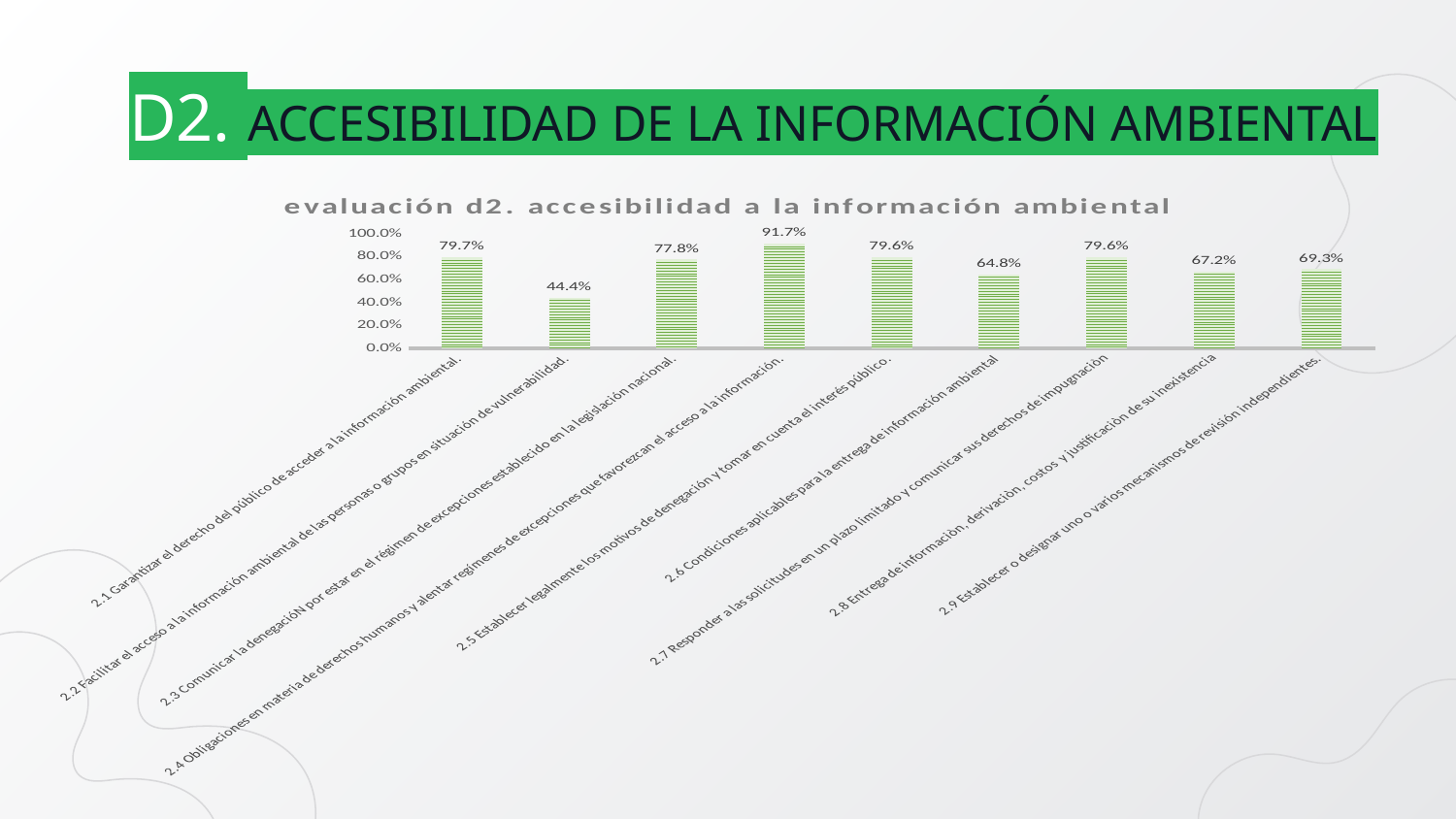
How many categories are plotted in the chart? 9 Which category has the highest value? 2.4 Obligaciones en materia de derechos humanos y alentar regímenes de excepciones que favorezcan el acceso a la información Which category has the lowest value? 2.2 Facilitar el acceso a la información ambiental de las personas o grupos en situación de vulnerabilidad Which has a larger value, category 2.6 or category 2.8? 2.8 Entrega de información, derivación, costos y justificación de su inexistencia What is the title of the chart? evaluación d2. accesibilidad a la información ambiental What is the value for category 2.4 (Obligaciones en materia de derechos humanos y alentar regímenes de excepciones que favorezcan el acceso a la información)? 91.7% What is the value for category 2.2 (Facilitar el acceso a la información ambiental de las personas o grupos en situación de vulnerabilidad)? 44.4% What is the difference between the highest value (category 2.4) and the lowest value (category 2.2)? 47.3 percentage points Is the value for category 2.2 greater or less than 60.0%? less What is the value for category 2.1 (Garantizar el derecho del público de acceder a la información ambiental)? 79.7% What is the value for category 2.9 (Establecer o designar uno o varios mecanismos de revisión independientes)? 69.3% What is the value for category 2.6 (Condiciones aplicables para la entrega de información ambiental)? 64.8%